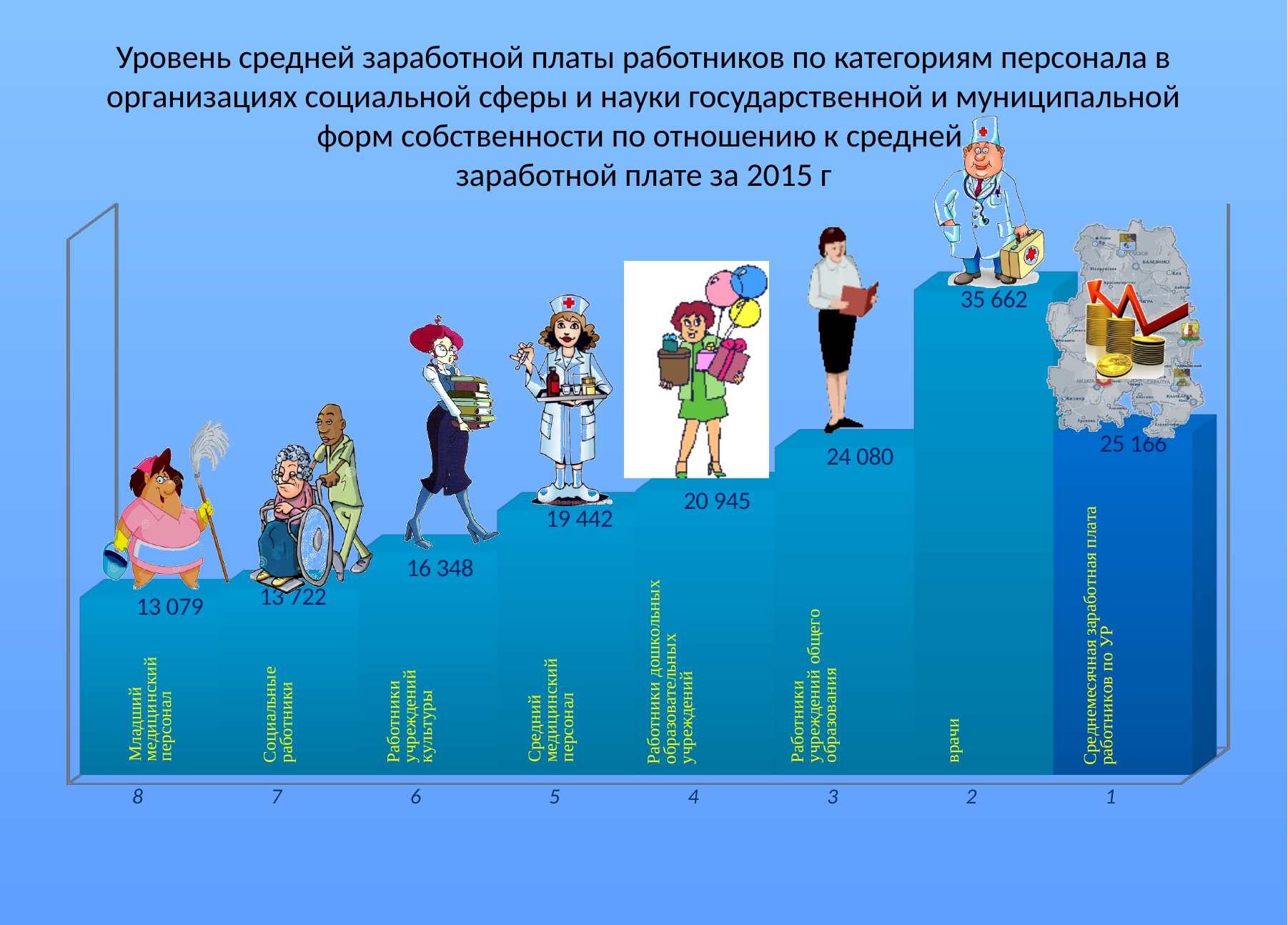
What is the value shown for Младший медицинский персонал? 13 079 Which category has the lowest value? Младший медицинский персонал What is the value shown for Работники дошкольных образовательных учреждений? 20 945 What is the difference between the value for врачи and the value for Среднемесячная заработная плата работников по УР? 10 496 How many bars are shown in the chart? 8 What is the value shown for Работники учреждений культуры? 16 348 What is the value shown for врачи? 35 662 What kind of chart is shown on the slide? bar chart What is the difference between the value for Работники учреждений общего образования and the value for Работники дошкольных образовательных учреждений? 3 135 Which category has the highest value? врачи Which is larger: the value for Средний медицинский персонал or the value for Социальные работники? Средний медицинский персонал What is the value shown for Среднемесячная заработная плата работников по УР? 25 166